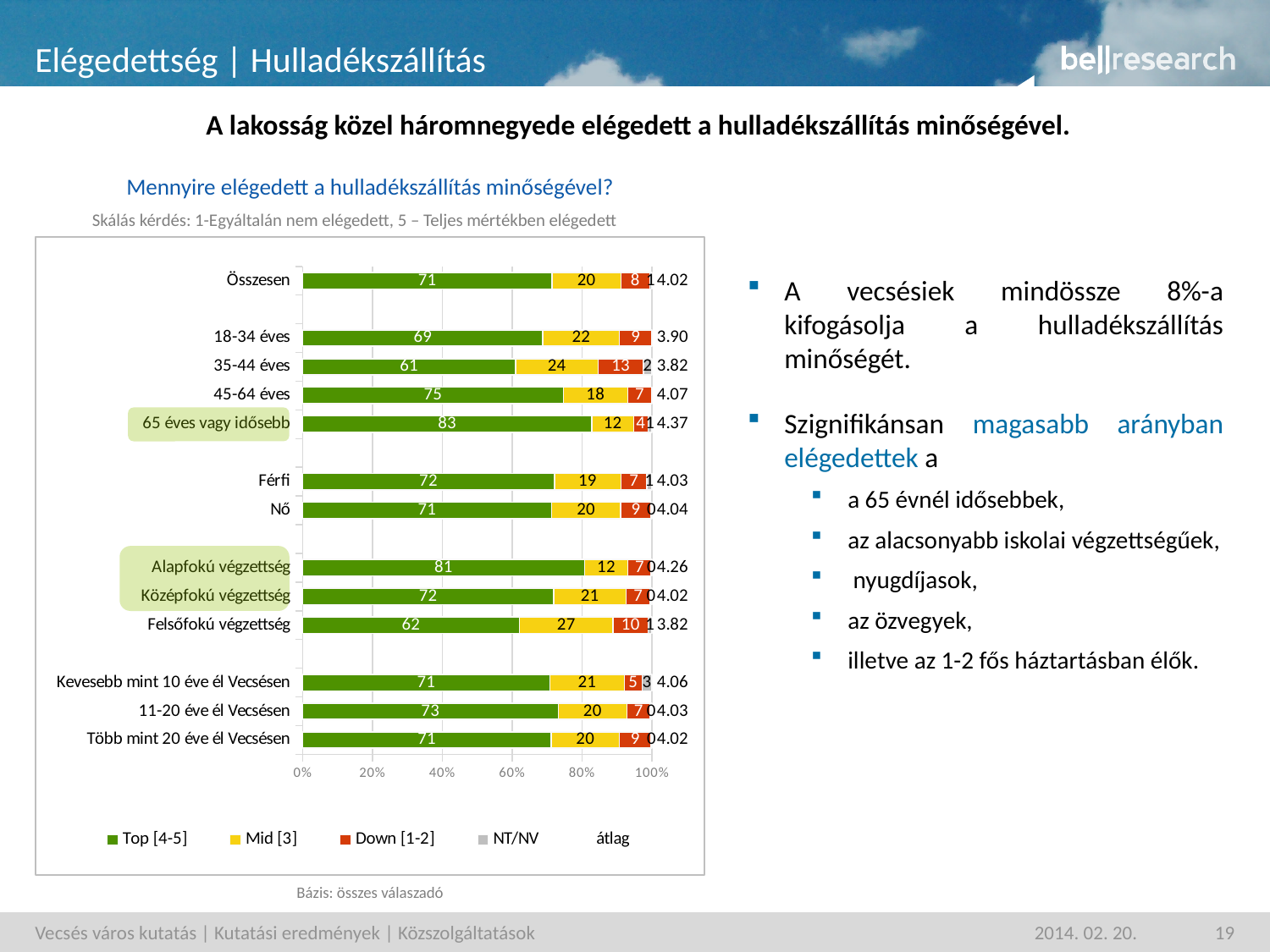
How many entries does the chart legend list? 5 What kind of chart is shown on the slide? Stacked bar chart How many categories are plotted on the chart? 13 What is the átlag (average) shown for the 'Összesen' category? 4.02 Which category has the lowest Top [4-5] value? 35-44 éves What is the Down [1-2] value for the '35-44 éves' category? 13 What is the difference between the Top [4-5] values of '65 éves vagy idősebb' and '35-44 éves'? 22 Which has a larger Mid [3] value: 'Felsőfokú végzettség' or 'Alapfokú végzettség'? Felsőfokú végzettség What is the Top [4-5] value for the '65 éves vagy idősebb' category? 83 Which category has the highest átlag (average) value? 65 éves vagy idősebb Which category has the highest Top [4-5] value? 65 éves vagy idősebb What is the title of the chart? Mennyire elégedett a hulladékszállítás minőségével?